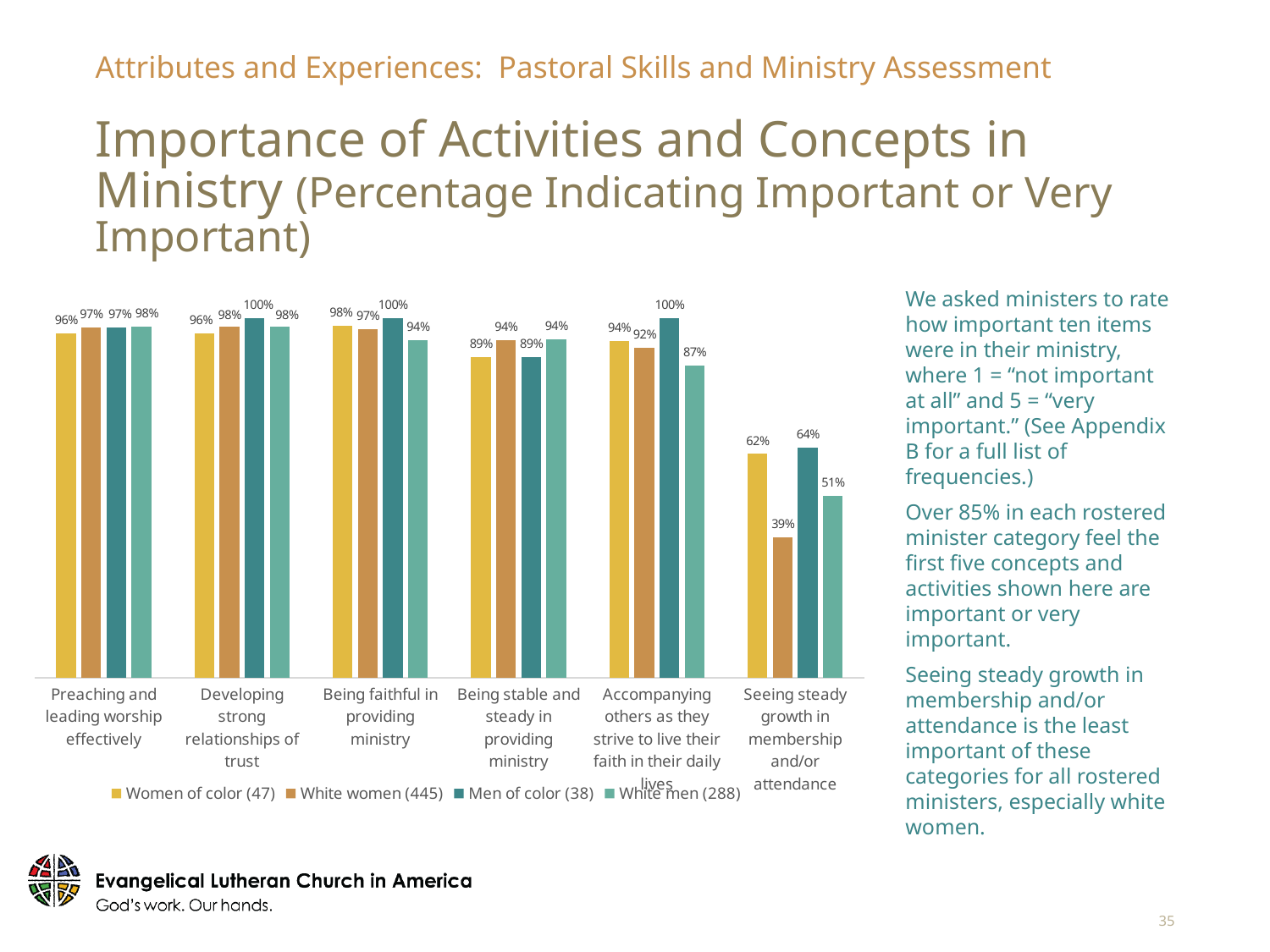
What is the value for Men of color for "Accompanying others as they strive to live their faith in their daily lives"? 100% How many categories are shown on the x axis of the chart? 6 What is the difference between the Men of color and White women values for "Seeing steady growth in membership and/or attendance"? 25% What is the value for Women of color for "Being stable and steady in providing ministry"? 89% What is the value for White men for "Being faithful in providing ministry"? 94% Which category has the lowest value for White women? Seeing steady growth in membership and/or attendance What percentage of White women rated "Seeing steady growth in membership and/or attendance" as important or very important? 39% Which group has the highest value for "Seeing steady growth in membership and/or attendance"? Men of color (38) For "Accompanying others as they strive to live their faith in their daily lives", which is larger: the value for Women of color or for White men? Women of color What is the sample size shown in the legend for White women? 445 What kind of chart is shown on the slide? Bar chart How many series does the legend list? 4